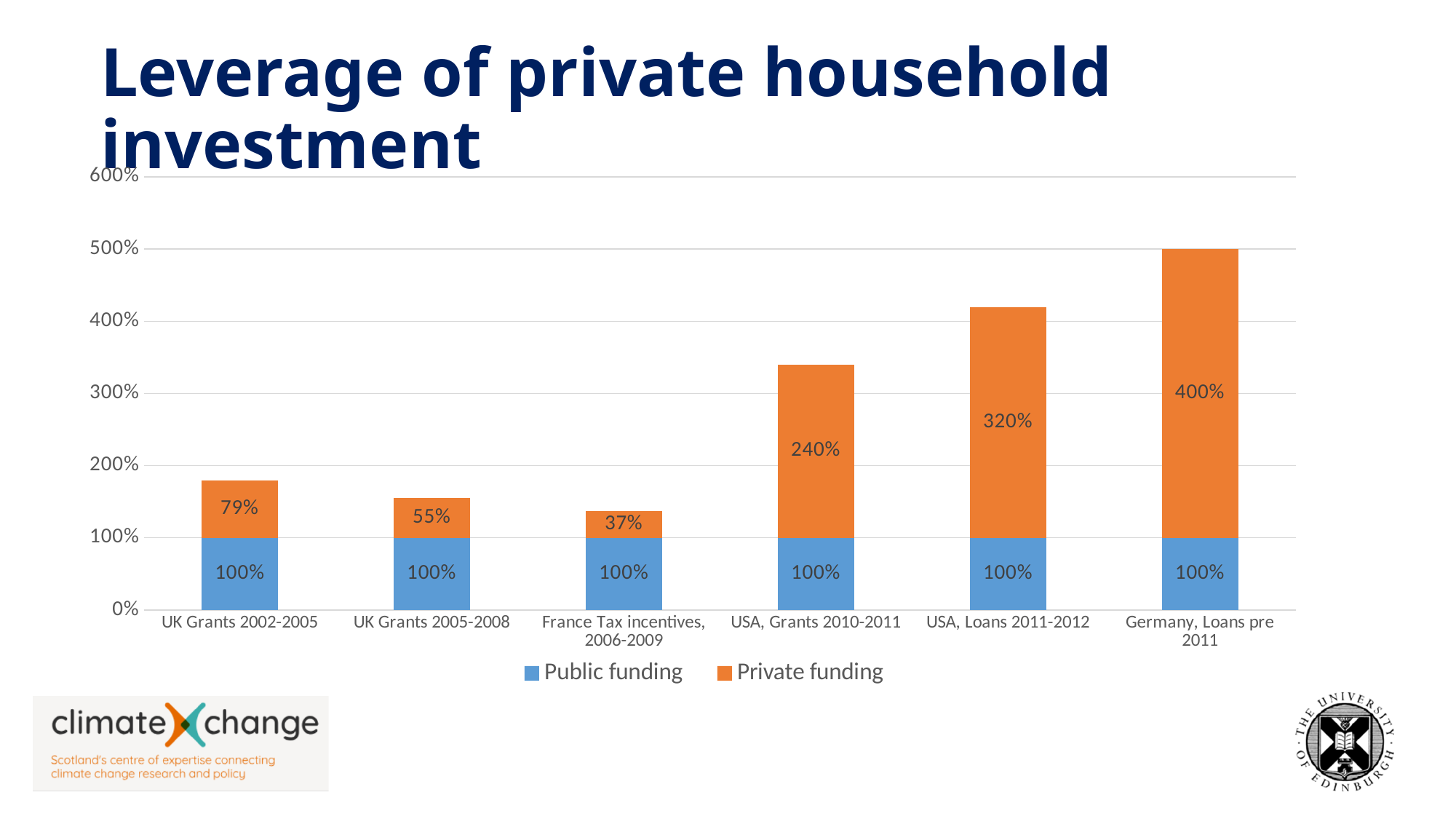
What is the total of the stacked bar for USA, Grants 2010-2011? 340% What is the difference between the Private funding values for UK Grants 2002-2005 and UK Grants 2005-2008? 24% What kind of chart is shown on the slide? Stacked bar chart What is the Public funding value for UK Grants 2002-2005? 100% What is the total of the stacked bar for Germany, Loans pre 2011? 500% What is the Private funding value for USA, Loans 2011-2012? 320% Which category has the lowest Private funding value? France Tax incentives, 2006-2009 Which has a larger Private funding value, USA, Grants 2010-2011 or USA, Loans 2011-2012? USA, Loans 2011-2012 Which category has the highest Private funding value? Germany, Loans pre 2011 What is the Private funding value for France Tax incentives, 2006-2009? 37% How many categories are shown on the x axis? 6 How many series does the legend list? 2